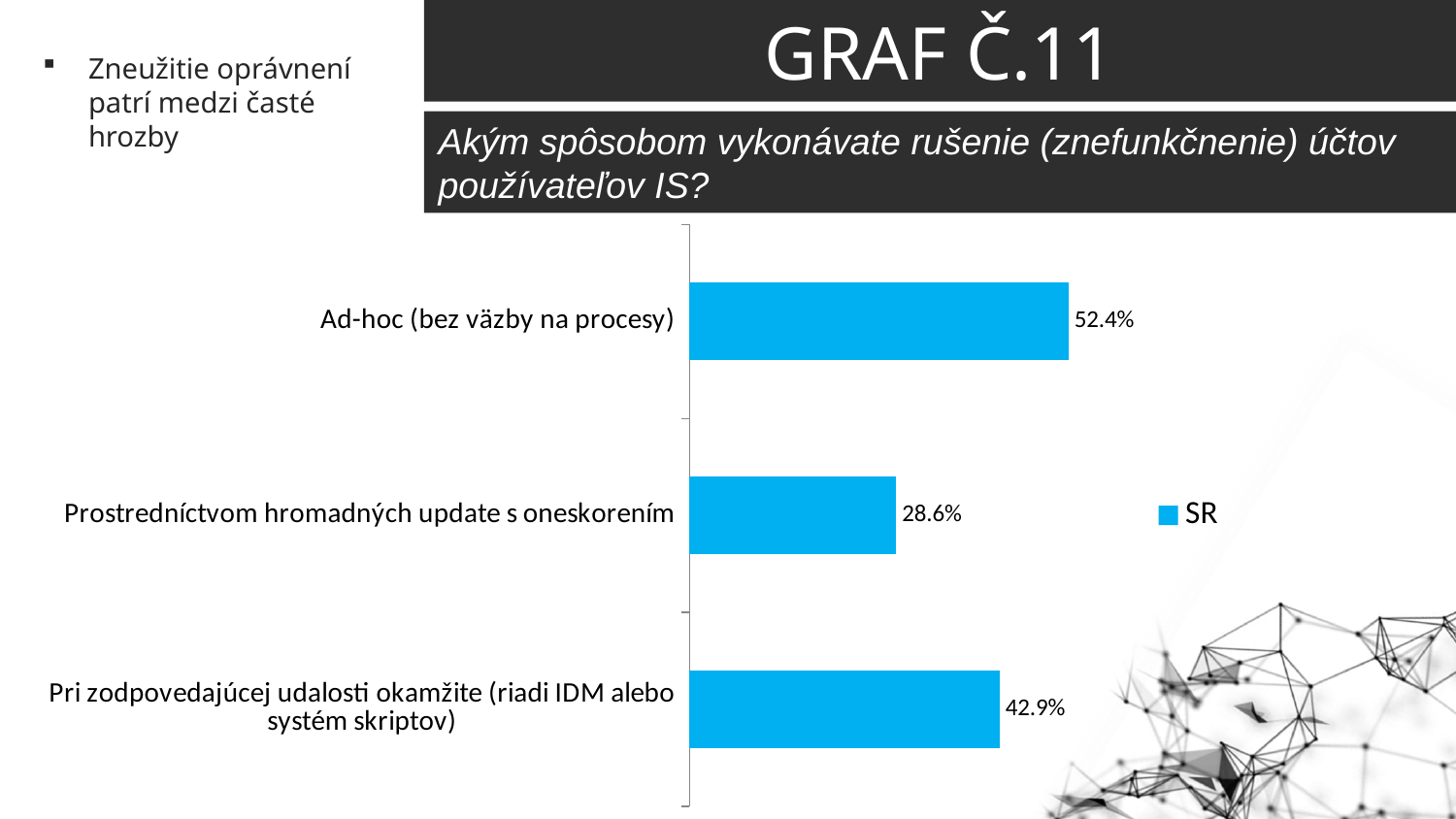
What is the difference between the values for "Ad-hoc (bez väzby na procesy)" and "Pri zodpovedajúcej udalosti okamžite (riadi IDM alebo systém skriptov)"? 9.5% Which category has the lowest value? Prostredníctvom hromadných update s oneskorením Which is larger: the value for "Pri zodpovedajúcej udalosti okamžite (riadi IDM alebo systém skriptov)" or for "Prostredníctvom hromadných update s oneskorením"? Pri zodpovedajúcej udalosti okamžite (riadi IDM alebo systém skriptov) What is the difference between the values for "Ad-hoc (bez väzby na procesy)" and "Prostredníctvom hromadných update s oneskorením"? 23.8% What is the name of the series shown in the legend? SR What is the value for "Ad-hoc (bez väzby na procesy)"? 52.4% How many categories are shown in the chart? 3 What is the value for "Prostredníctvom hromadných update s oneskorením"? 28.6% What kind of chart is shown on the slide? Bar chart Which category has the highest value? Ad-hoc (bez väzby na procesy) What is the value for "Pri zodpovedajúcej udalosti okamžite (riadi IDM alebo systém skriptov)"? 42.9% How many series does the legend list? 1